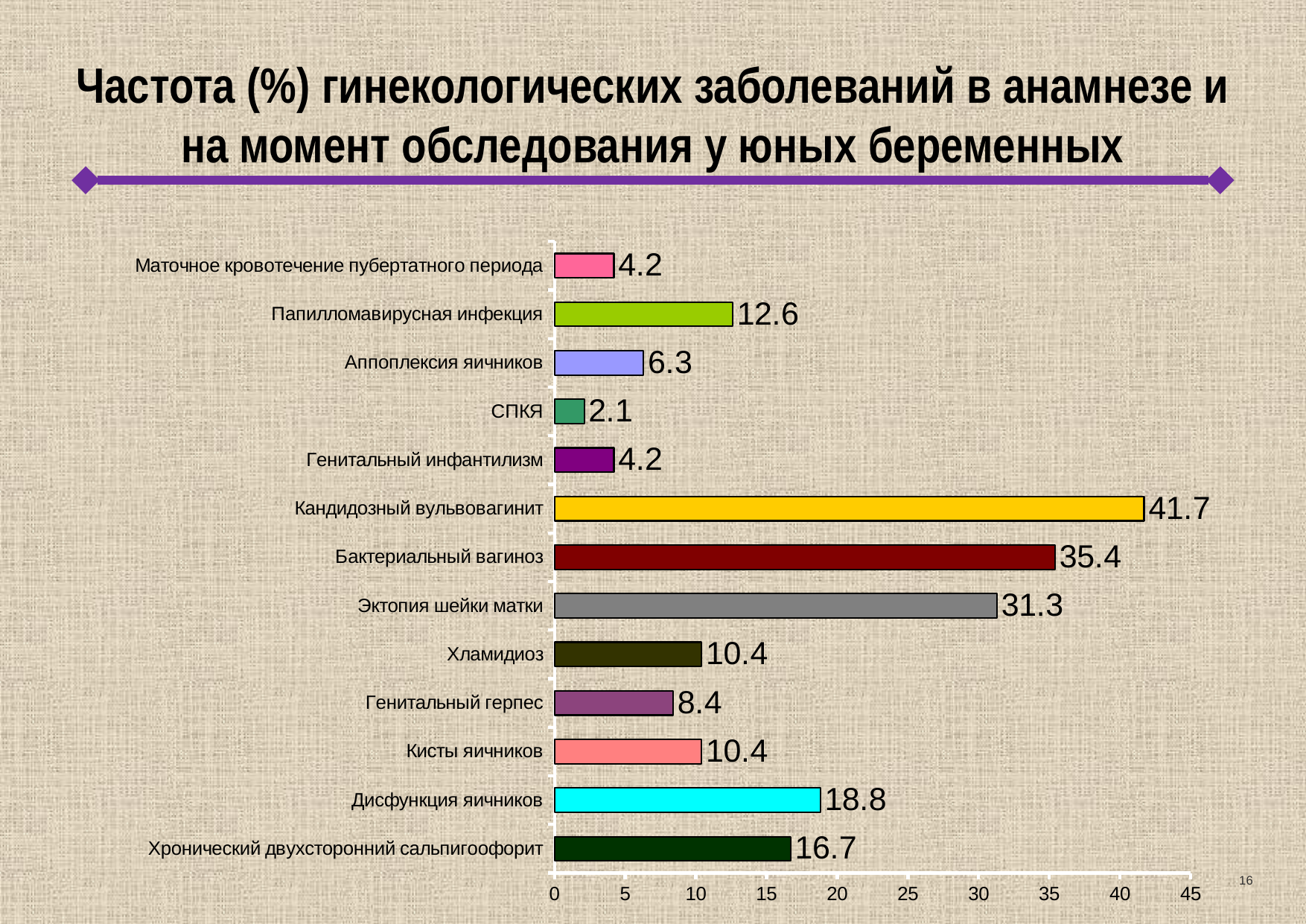
Which category has the lowest value? СПКЯ What kind of chart is shown on the slide? bar chart Which is larger: the value for Папилломавирусная инфекция or the value for Хламидиоз? Папилломавирусная инфекция What is the value for Дисфункция яичников? 18.8 Is the value for Хронический двухсторонний сальпигоофорит greater or less than 15? greater What is the value for СПКЯ? 2.1 What is the difference between the values for Кандидозный вульвовагинит and Бактериальный вагиноз? 6.3 What is the value for Кандидозный вульвовагинит? 41.7 How many categories are shown in the chart? 13 Which category has the highest value? Кандидозный вульвовагинит What is the difference between the values for Бактериальный вагиноз and Эктопия шейки матки? 4.1 What colour is the bar for Кандидозный вульвовагинит? yellow